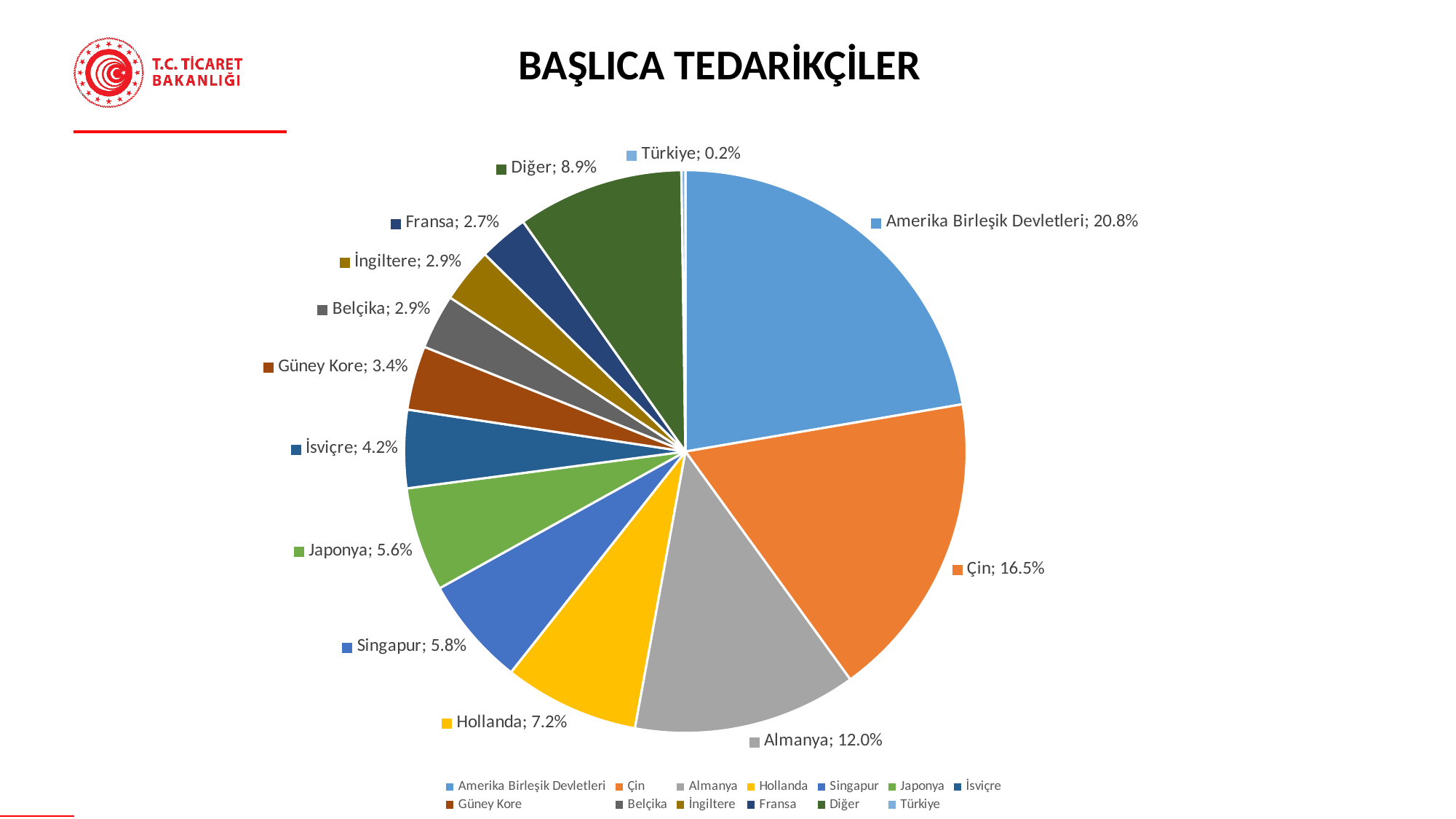
Which category has the largest slice of the pie? Amerika Birleşik Devletleri What is the share for Çin? 16.5% What is the difference between the shares of Almanya and Hollanda? 4.8% What is the share for Amerika Birleşik Devletleri? 20.8% What is the share for Türkiye? 0.2% What is the share for Hollanda? 7.2% What is the title of the chart? BAŞLICA TEDARİKÇİLER Which is larger, the share for Singapur or the share for Japonya? Singapur Which category has the smallest slice of the pie? Türkiye What kind of chart is shown on the slide? pie chart What is the difference between the shares of Amerika Birleşik Devletleri and Çin? 4.3% How many slices does the pie chart have? 13